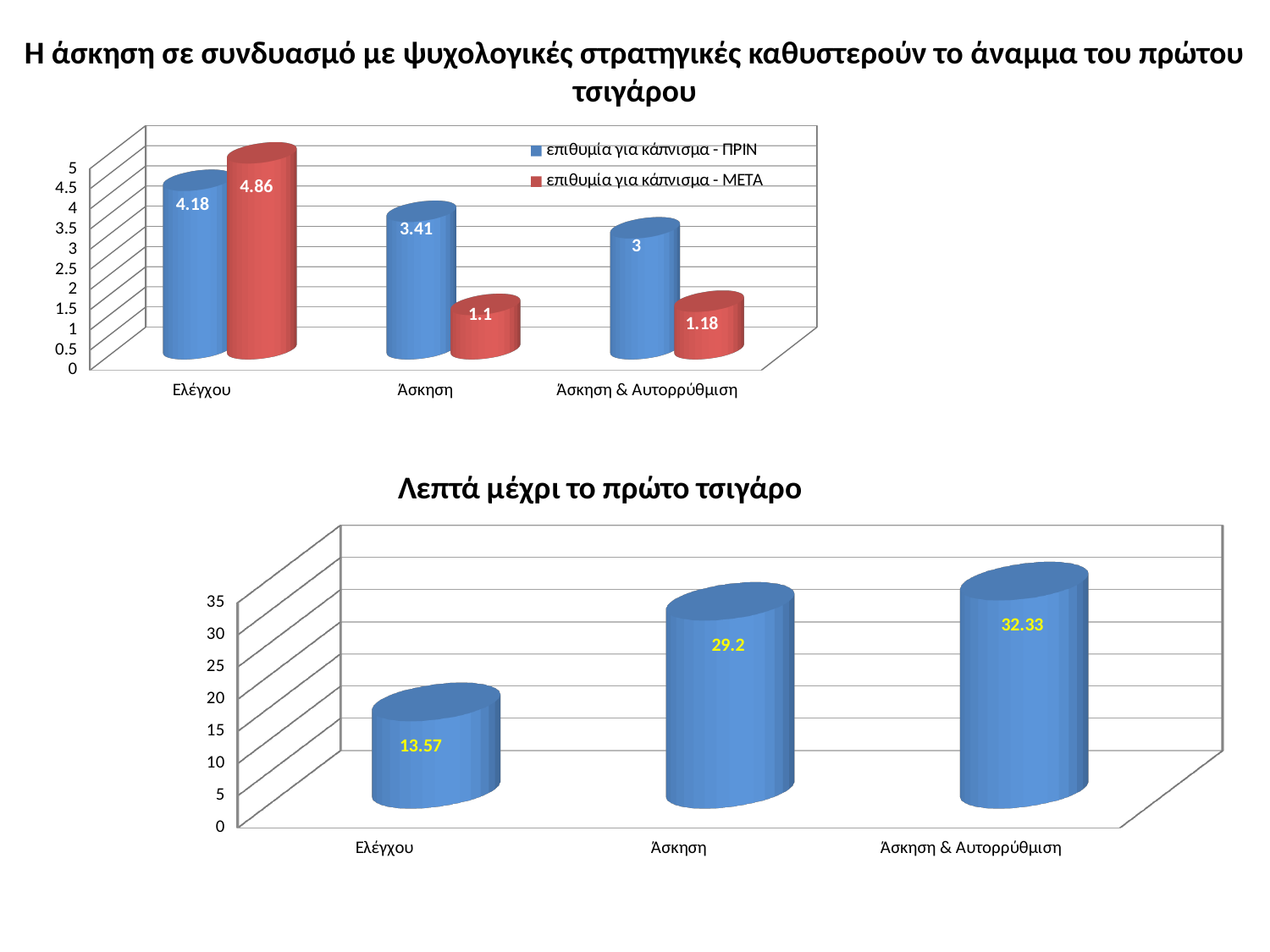
In the top chart, what is the value of επιθυμία για κάπνισμα - ΜΕΤΑ for Άσκηση? 1.1 In the top chart, what is the value of επιθυμία για κάπνισμα - ΜΕΤΑ for Άσκηση & Αυτορρύθμιση? 1.18 What kind of chart is the chart titled 'Λεπτά μέχρι το πρώτο τσιγάρο'? Bar chart In the chart titled 'Λεπτά μέχρι το πρώτο τσιγάρο', what is the difference between Άσκηση & Αυτορρύθμιση and Άσκηση? 3.13 In the chart titled 'Λεπτά μέχρι το πρώτο τσιγάρο', what is the value for Ελέγχου? 13.57 In the top chart, for Άσκηση, which is larger: the ΠΡΙΝ value or the ΜΕΤΑ value? ΠΡΙΝ How many series does the legend of the top chart list? 2 In the top chart, which category has the highest επιθυμία για κάπνισμα - ΜΕΤΑ value? Ελέγχου In the chart titled 'Λεπτά μέχρι το πρώτο τσιγάρο', which category has the highest value? Άσκηση & Αυτορρύθμιση In the top chart, what is the value of επιθυμία για κάπνισμα - ΠΡΙΝ for Ελέγχου? 4.18 In the top chart, what is the difference between the ΠΡΙΝ and ΜΕΤΑ values for Ελέγχου? 0.68 How many categories are shown in the chart titled 'Λεπτά μέχρι το πρώτο τσιγάρο'? 3